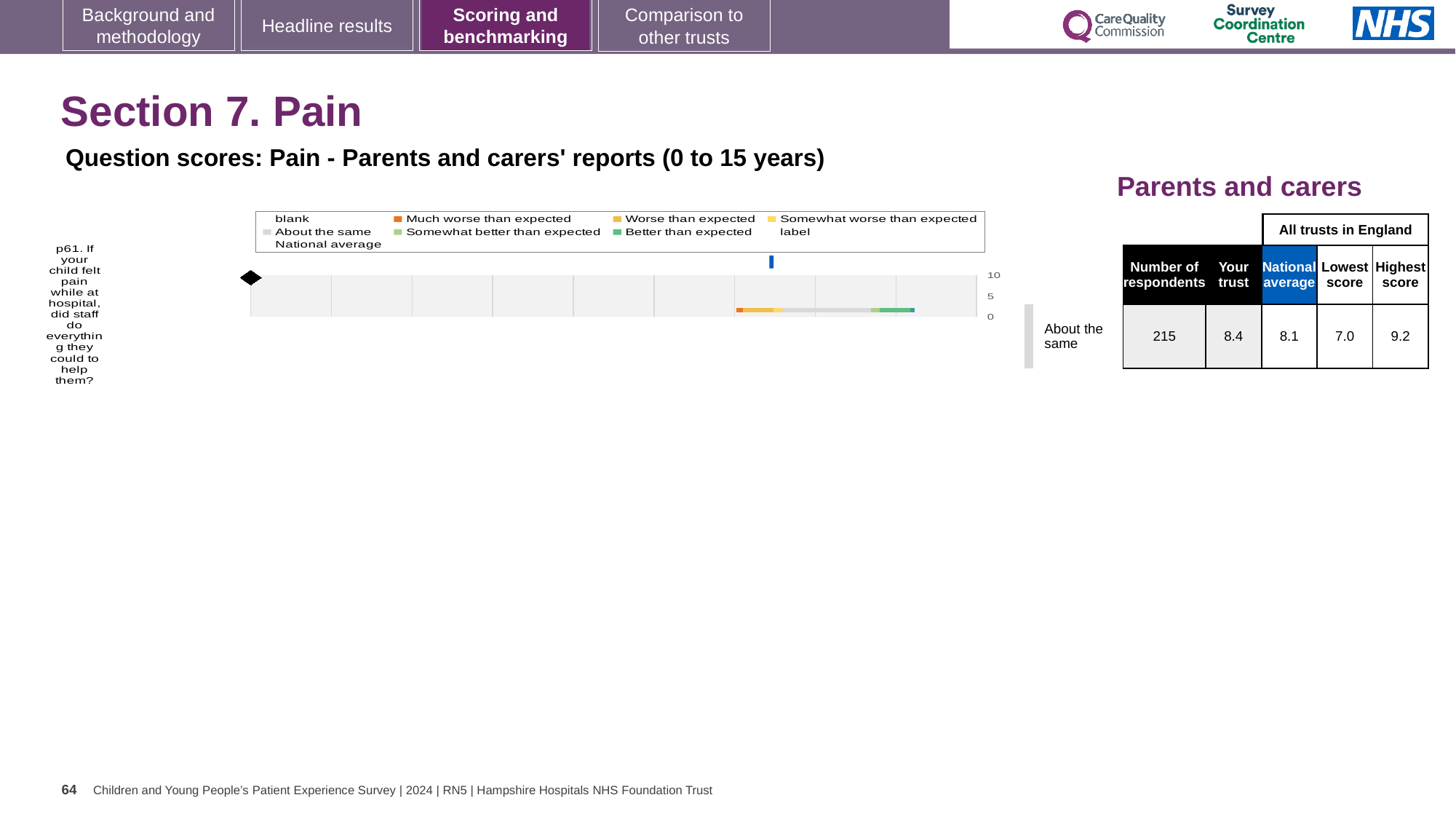
In the Parents and carers table, what is the National average score? 8.1 What is the highest tick value shown on the chart's axis? 10 In the Parents and carers table, what is the difference between the Highest score and the Lowest score? 2.2 In the Parents and carers table, what is the Highest score among all trusts in England? 9.2 What kind of chart is shown on the slide for question p61? bar chart In the Parents and carers table, how much higher is the 'Your trust' score than the National average? 0.3 In the Parents and carers table, what is the 'Your trust' score for the 'About the same' row? 8.4 How many survey questions are plotted in the chart? 1 In the chart legend, which category is shown in orange? Much worse than expected In the Parents and carers table, how many respondents are listed? 215 In the Parents and carers table, which is larger: the 'Your trust' score or the National average? Your trust In the Parents and carers table, what is the Lowest score among all trusts in England? 7.0